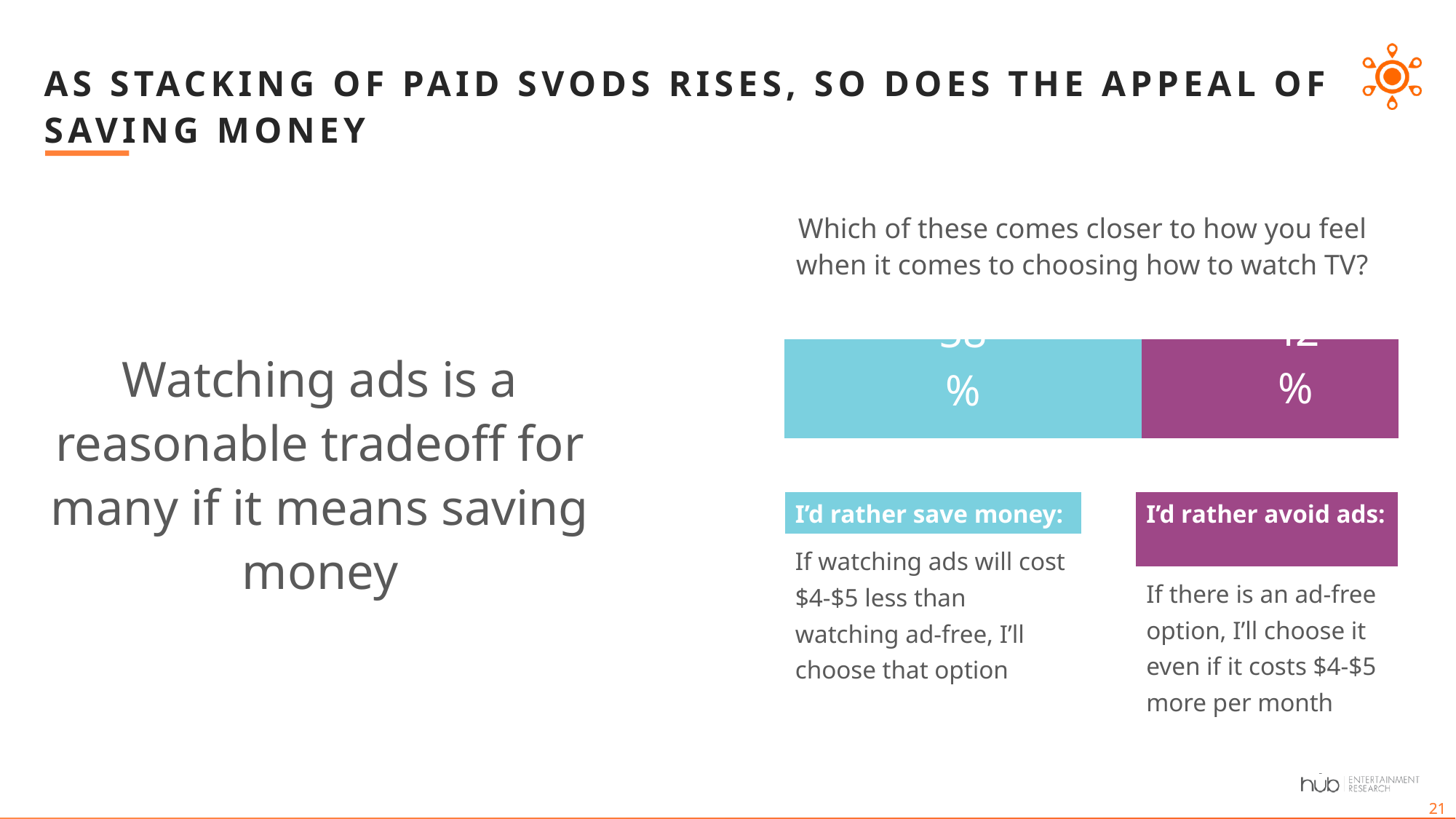
What colour is the "I'd rather save money" segment of the bar? teal (light blue) Which response option has the smallest share of the bar? I'd rather avoid ads Is the share for "I'd rather avoid ads" greater or less than 50%? less Which response option has the largest share of the bar? I'd rather save money What colour is the "I'd rather avoid ads" segment of the bar? purple What kind of chart is shown on the slide? bar chart How many segments does the stacked bar on the slide have? 2 Is the share for "I'd rather save money" greater or less than 50%? greater How many response options does the chart's legend list? 2 Which segment of the bar is larger: "I'd rather save money" or "I'd rather avoid ads"? I'd rather save money